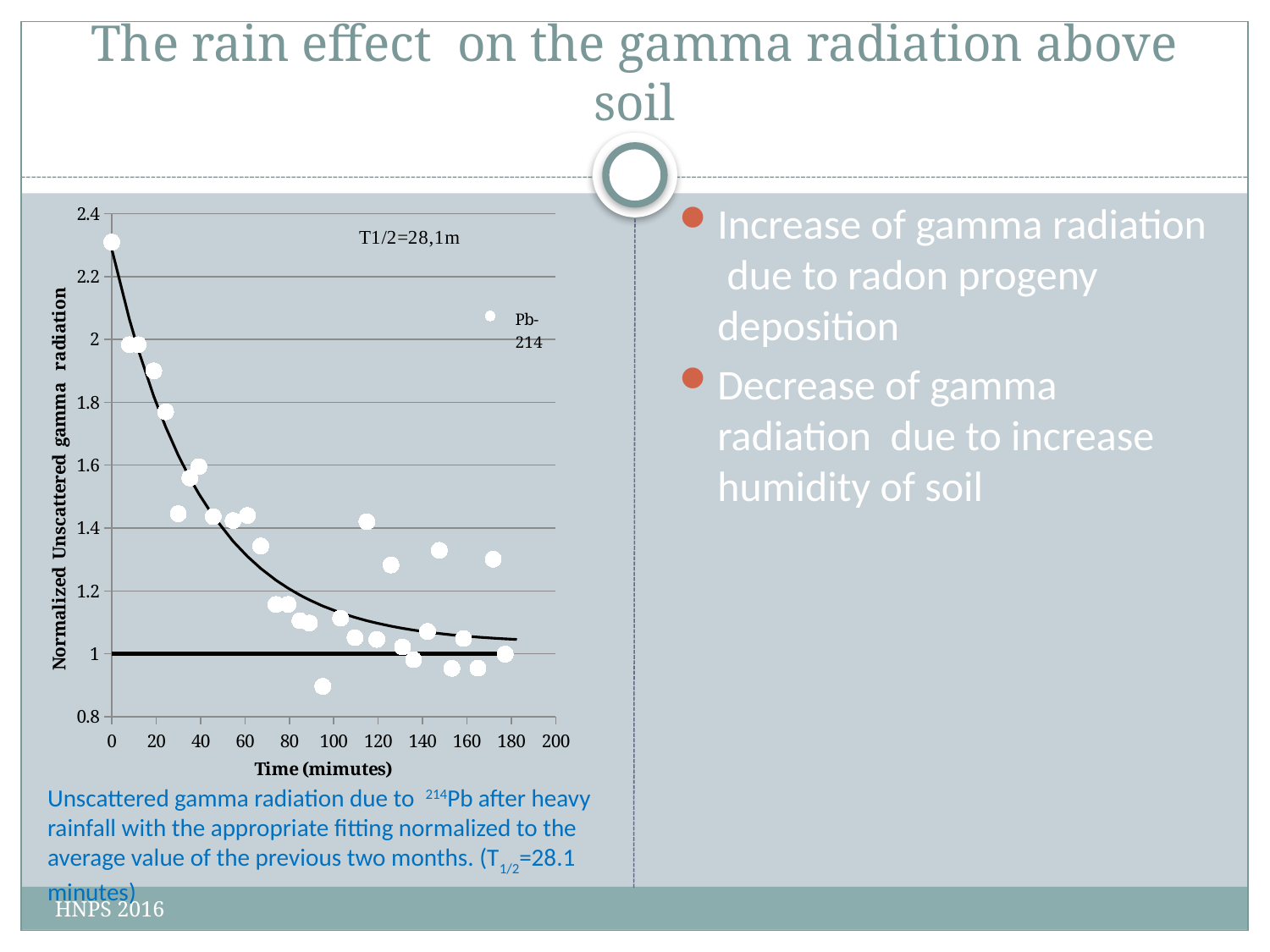
What kind of chart is shown on the slide? scatter chart Is the Pb-214 value at time 0 greater or less than 2.2? greater What is the maximum value shown on the x axis of the chart? 200 What series name appears in the chart legend? Pb-214 What half-life value is annotated on the chart? T1/2=28,1m Is the lowest plotted Pb-214 value greater or less than 1? less What is the title of the x axis of the chart? Time (mimutes) What is the maximum value shown on the y axis of the chart? 2.4 At which time (in minutes) does the highest plotted Pb-214 value occur? 0 How many series does the chart legend list? 1 Is the Pb-214 value at 180 minutes greater or less than 1.2? less Do the plotted Pb-214 values generally rise or fall as time increases along the x axis? fall